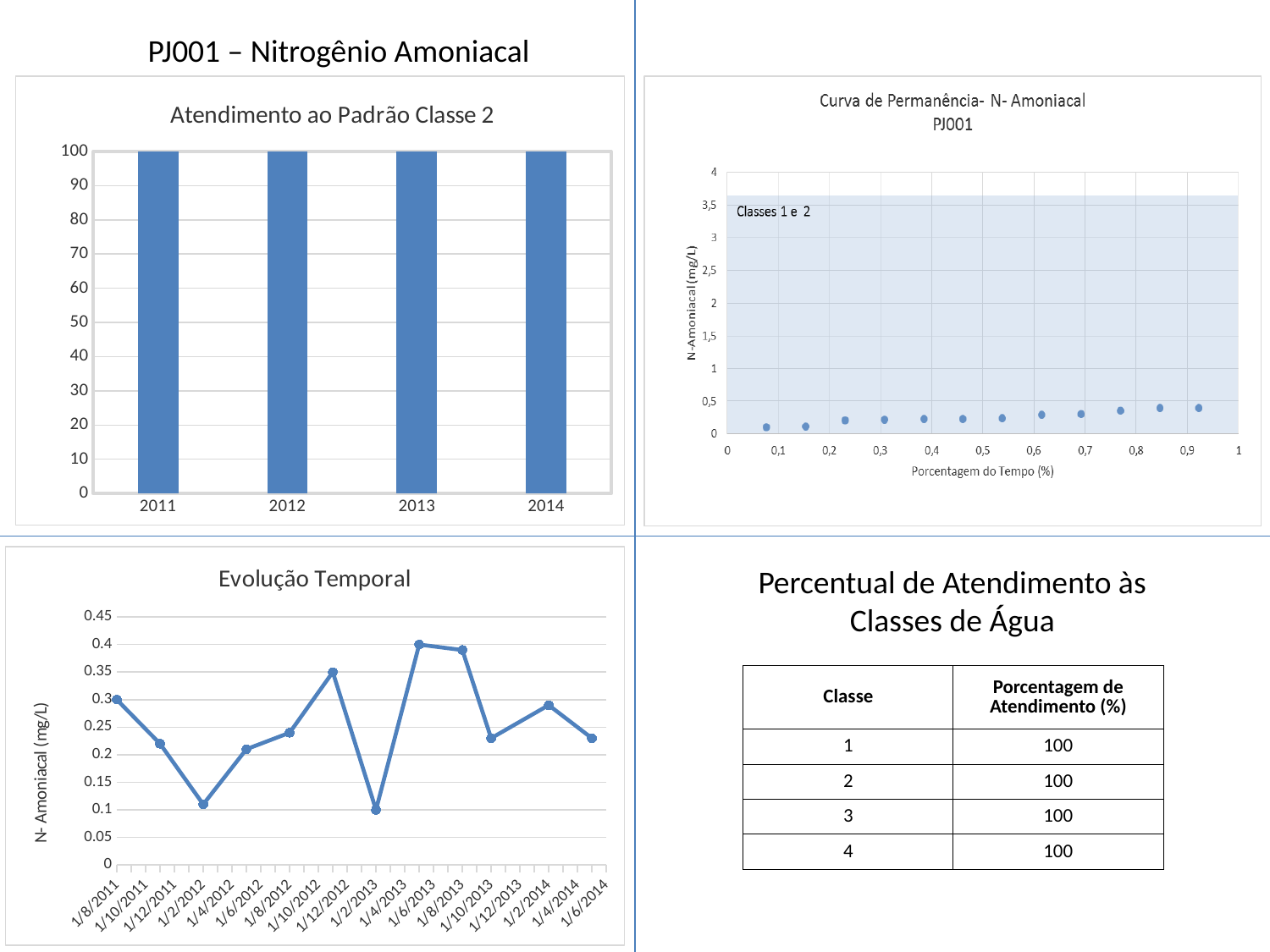
In the chart titled 'Atendimento ao Padrão Classe 2', is the value for 2013 greater or less than 50? greater In the chart titled 'Evolução Temporal', what is the value for 1/8/2011? 0.3 In the chart titled 'Atendimento ao Padrão Classe 2', what is the value for 2014? 100 What kind of chart is 'Atendimento ao Padrão Classe 2'? bar chart In the chart titled 'Atendimento ao Padrão Classe 2', what is the value for 2012? 100 What kind of chart is 'Curva de Permanência- N- Amoniacal PJ001'? scatter chart In the chart titled 'Evolução Temporal', which is larger, the value for 1/8/2011 or the value for 1/2/2012? 1/8/2011 What is the y-axis label of the chart titled 'Curva de Permanência- N- Amoniacal PJ001'? N-Amoniacal (mg/L) How many categories are shown on the x axis of the chart titled 'Atendimento ao Padrão Classe 2'? 4 How many data points are plotted in the chart titled 'Curva de Permanência- N- Amoniacal PJ001'? 12